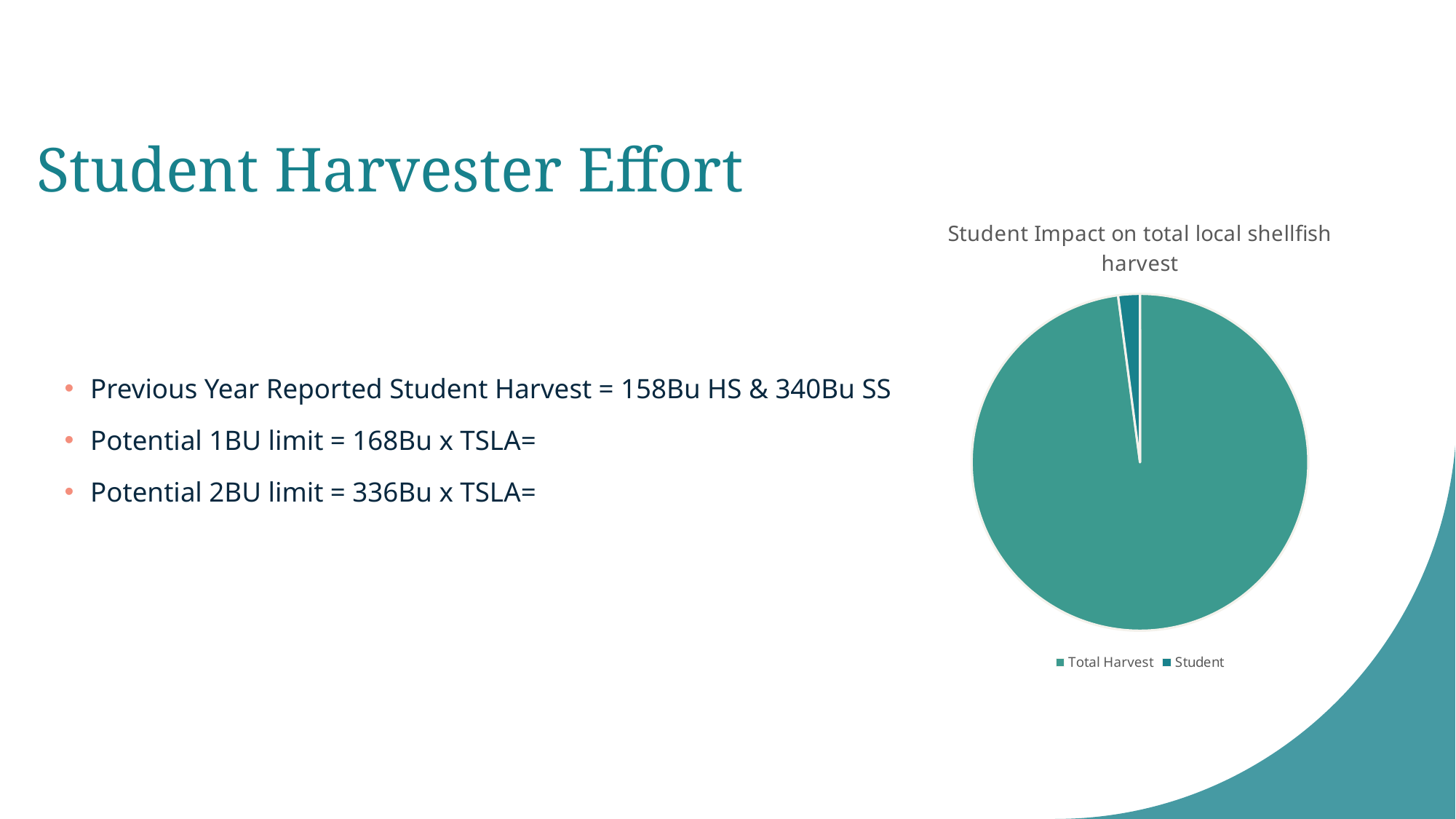
How many slices does the pie chart have? 2 What is the title of the chart? Student Impact on total local shellfish harvest What kind of chart is shown on the slide? pie chart How many series does the chart legend list? 2 Which is larger in the pie chart, Total Harvest or Student? Total Harvest Which slice of the pie chart is the largest? Total Harvest What are the two legend entries of the chart? Total Harvest, Student Which slice of the pie chart is the smallest? Student